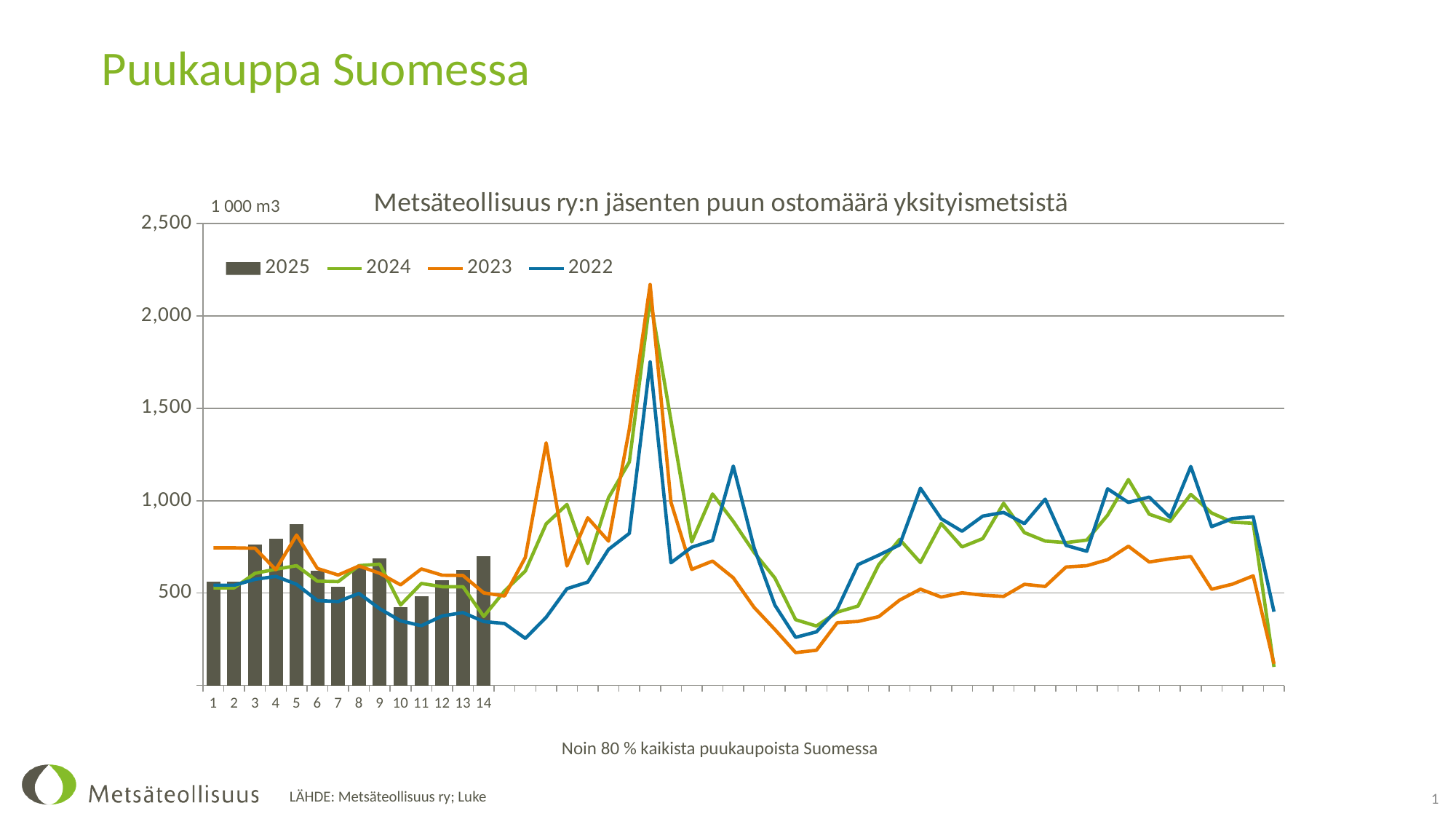
Is the 2025 value for week 5 greater or less than 500? greater How many weeks have a 2025 bar plotted? 14 Does the 2023 line rise or fall at the far right end of the chart? fall Is the 2025 value for week 10 greater or less than 500? less Which years are listed in the chart legend? 2025, 2024, 2023, 2022 Is the highest point of the 2022 line greater or less than 2,000? less What kind of chart is shown on the slide? A combined bar and line chart Which series reaches a higher peak, 2023 or 2022? 2023 Which week has the highest 2025 bar? 5 How many series does the chart legend list? 4 What is the title of the chart? Metsäteollisuus ry:n jäsenten puun ostomäärä yksityismetsistä